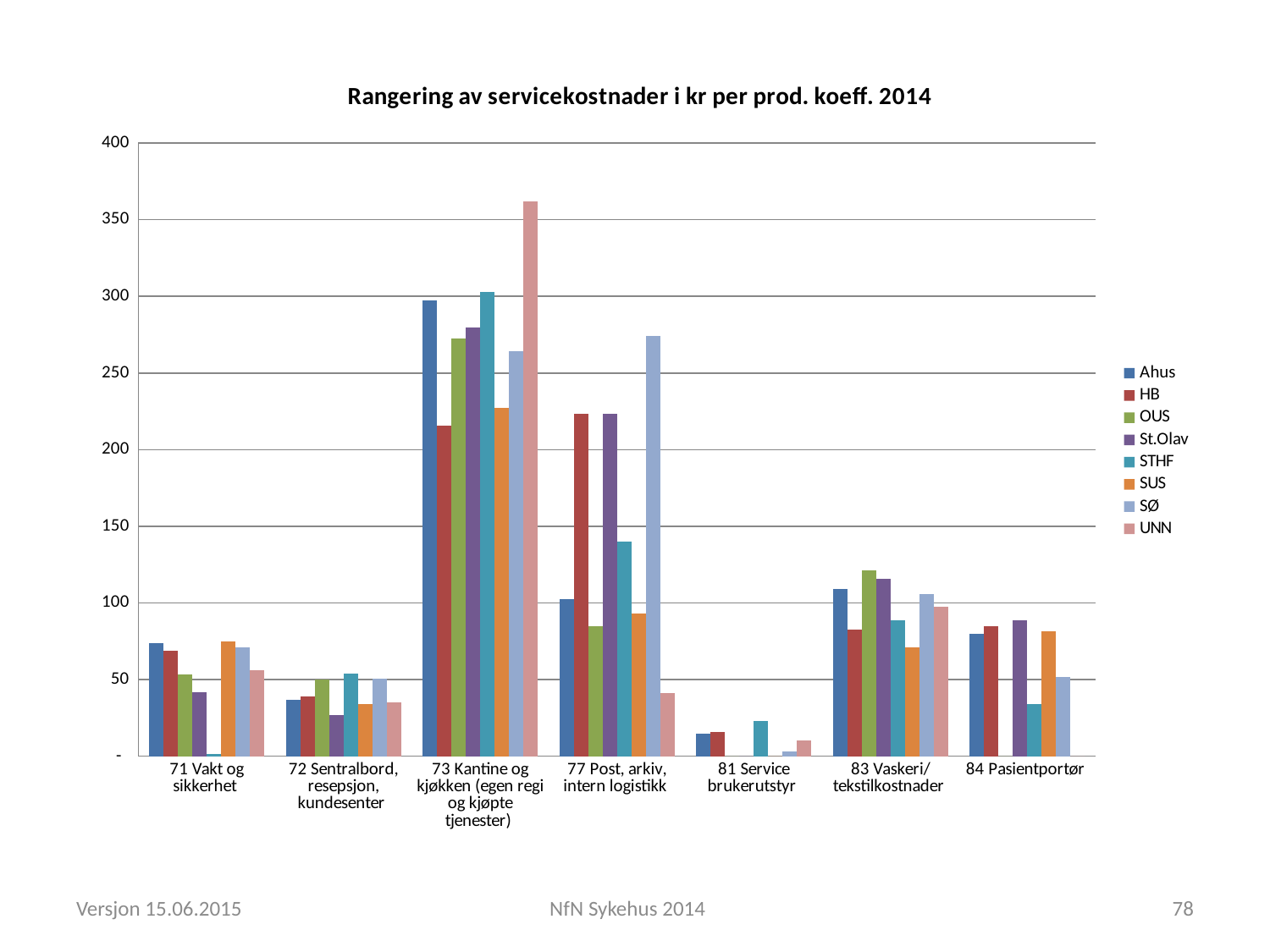
Is the value for UNN in 73 Kantine og kjøkken (egen regi og kjøpte tjenester) greater or less than 350? greater Is the value for HB in 73 Kantine og kjøkken (egen regi og kjøpte tjenester) greater or less than 200? greater For 77 Post, arkiv, intern logistikk, which is larger: STHF or OUS? STHF Which series has the highest value for 77 Post, arkiv, intern logistikk? SØ Which series has the lowest value for 83 Vaskeri/tekstilkostnader? SUS How many series does the legend list? 8 What kind of chart is shown on the slide? Bar chart For 84 Pasientportør, which is larger: STHF or SØ? SØ How many categories are shown on the x axis? 7 What is the title of the chart? Rangering av servicekostnader i kr per prod. koeff. 2014 Is the value for SØ in 77 Post, arkiv, intern logistikk greater or less than 250? greater Which series has the highest value for 73 Kantine og kjøkken (egen regi og kjøpte tjenester)? UNN